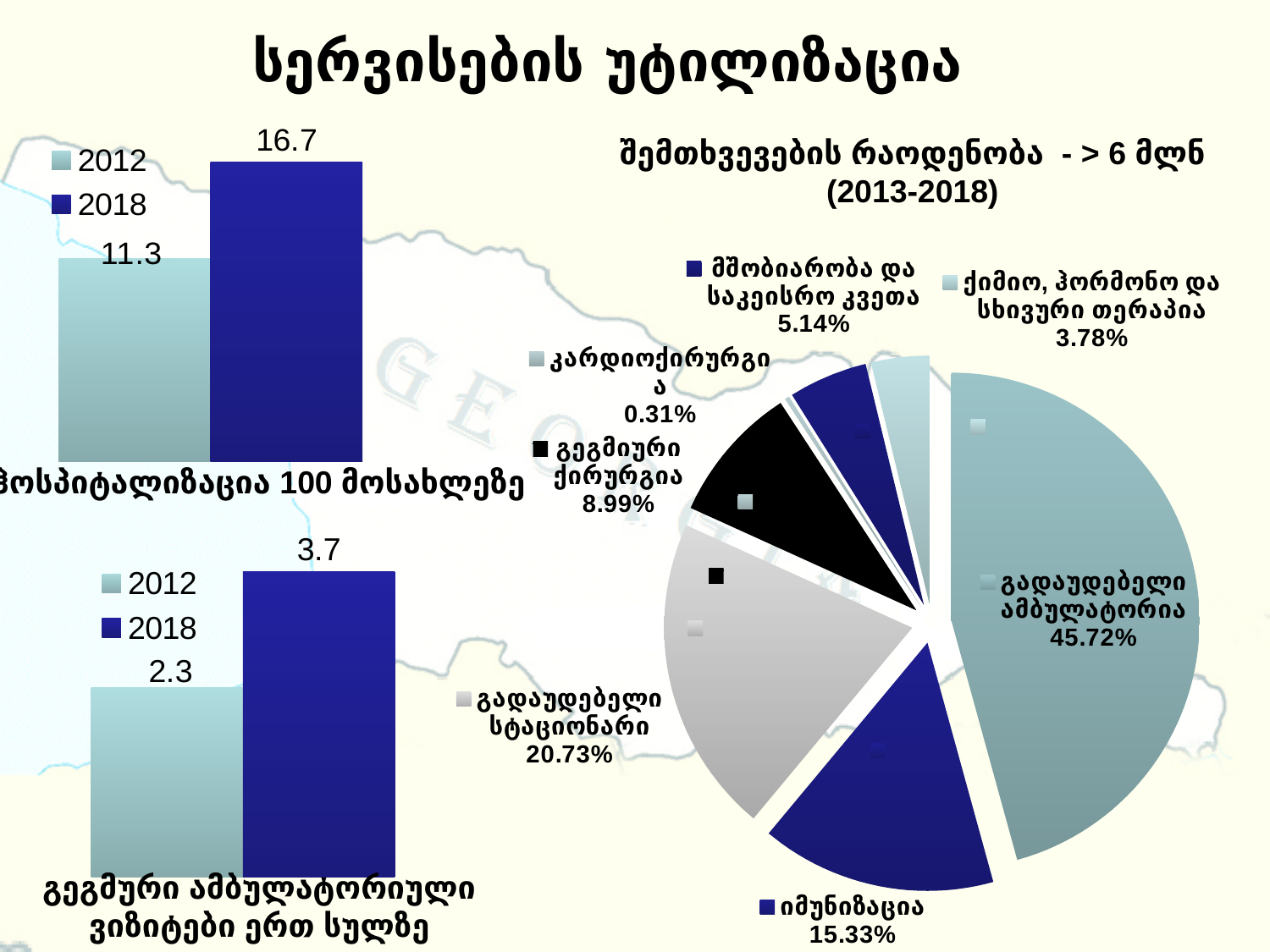
How many series does the legend of the bottom-left bar chart list? 2 In the bottom-left bar chart (გეგმური ამბულატორიული ვიზიტები ერთ სულზე), which year has the larger value, 2012 or 2018? 2018 In the top-left bar chart (ჰოსპიტალიზაცია 100 მოსახლეზე), what is the value for 2018? 16.7 What kind of chart is the chart on the right titled შემთხვევების რაოდენობა - > 6 მლნ (2013-2018)? pie chart In the top-left bar chart (ჰოსპიტალიზაცია 100 მოსახლეზე), what is the value for 2012? 11.3 In the bottom-left bar chart (გეგმური ამბულატორიული ვიზიტები ერთ სულზე), what is the value for 2012? 2.3 In the pie chart on the right, what is the share for იმუნიზაცია? 15.33% In the top-left bar chart (ჰოსპიტალიზაცია 100 მოსახლეზე), what is the difference between the 2018 and 2012 values? 5.4 In the pie chart on the right, what share does გადაუდებელი ამბულატორია have? 45.72% In the pie chart on the right, which category has the smallest share? კარდიოქირურგია In the bottom-left bar chart (გეგმური ამბულატორიული ვიზიტები ერთ სულზე), what is the value for 2018? 3.7 How many slices does the pie chart on the right have? 7